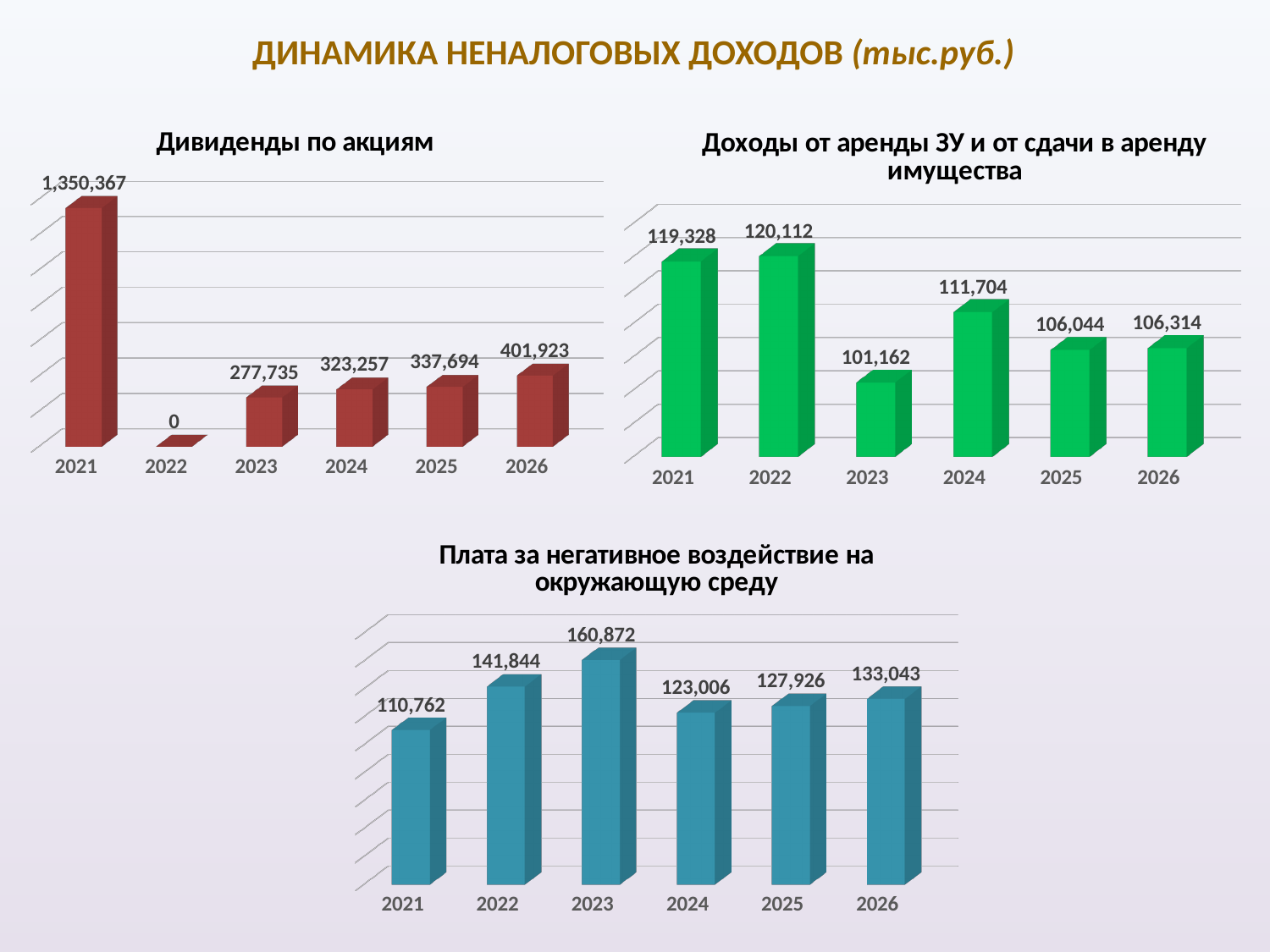
In the chart 'Доходы от аренды ЗУ и от сдачи в аренду имущества', what is the value for 2024? 111,704 In the chart 'Плата за негативное воздействие на окружающую среду', what is the value for 2023? 160,872 How many charts are shown on the slide? 3 In the chart 'Плата за негативное воздействие на окружающую среду', which is larger, the value for 2025 or the value for 2024? 2025 In the chart 'Дивиденды по акциям', what is the difference between the values for 2026 and 2025? 64,229 In the chart 'Доходы от аренды ЗУ и от сдачи в аренду имущества', what is the difference between the values for 2022 and 2021? 784 In the chart 'Плата за негативное воздействие на окружающую среду', which year has the lowest value? 2021 In the chart 'Доходы от аренды ЗУ и от сдачи в аренду имущества', which year has the lowest value? 2023 In the chart 'Дивиденды по акциям', which year has the highest value? 2021 In the chart 'Дивиденды по акциям', what is the value for 2022? 0 In the chart 'Плата за негативное воздействие на окружающую среду', what is the difference between the values for 2023 and 2022? 19,028 In the chart 'Дивиденды по акциям', what is the value for 2021? 1,350,367